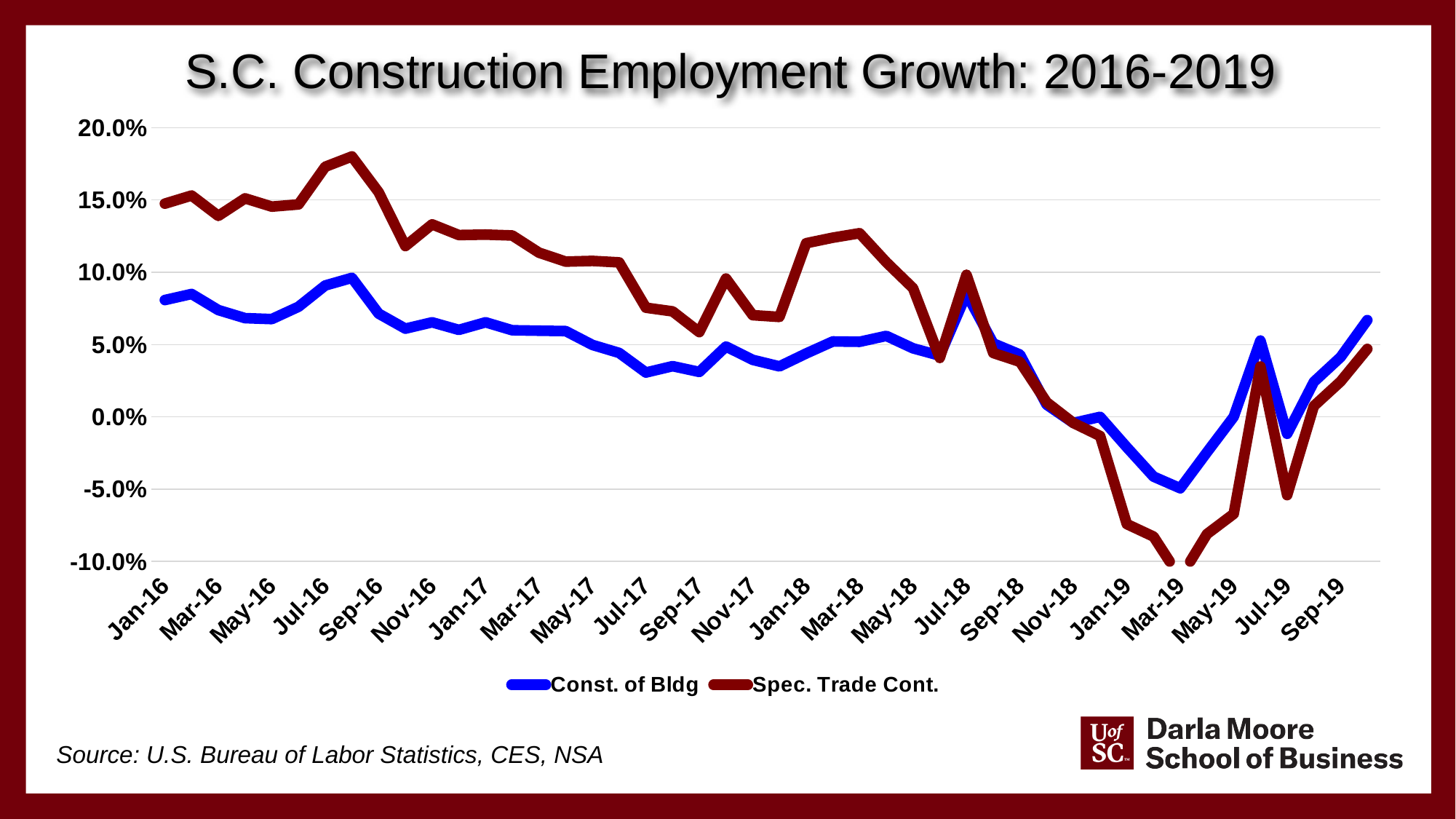
Is the value for Const. of Bldg in Jul-18 greater or less than 5.0%? greater What kind of chart is shown on the slide? Line chart In Jul-19, which series has the higher value, Const. of Bldg or Spec. Trade Cont.? Const. of Bldg Is the value for Const. of Bldg in Jan-16 greater or less than 10.0%? less Which series is drawn in blue? Const. of Bldg Is the value for Spec. Trade Cont. in Mar-19 greater or less than -5.0%? less How many series does the legend list? 2 Does the Spec. Trade Cont. series generally rise or fall from Jan-16 to Mar-19? Fall What is the title of the chart? S.C. Construction Employment Growth: 2016-2019